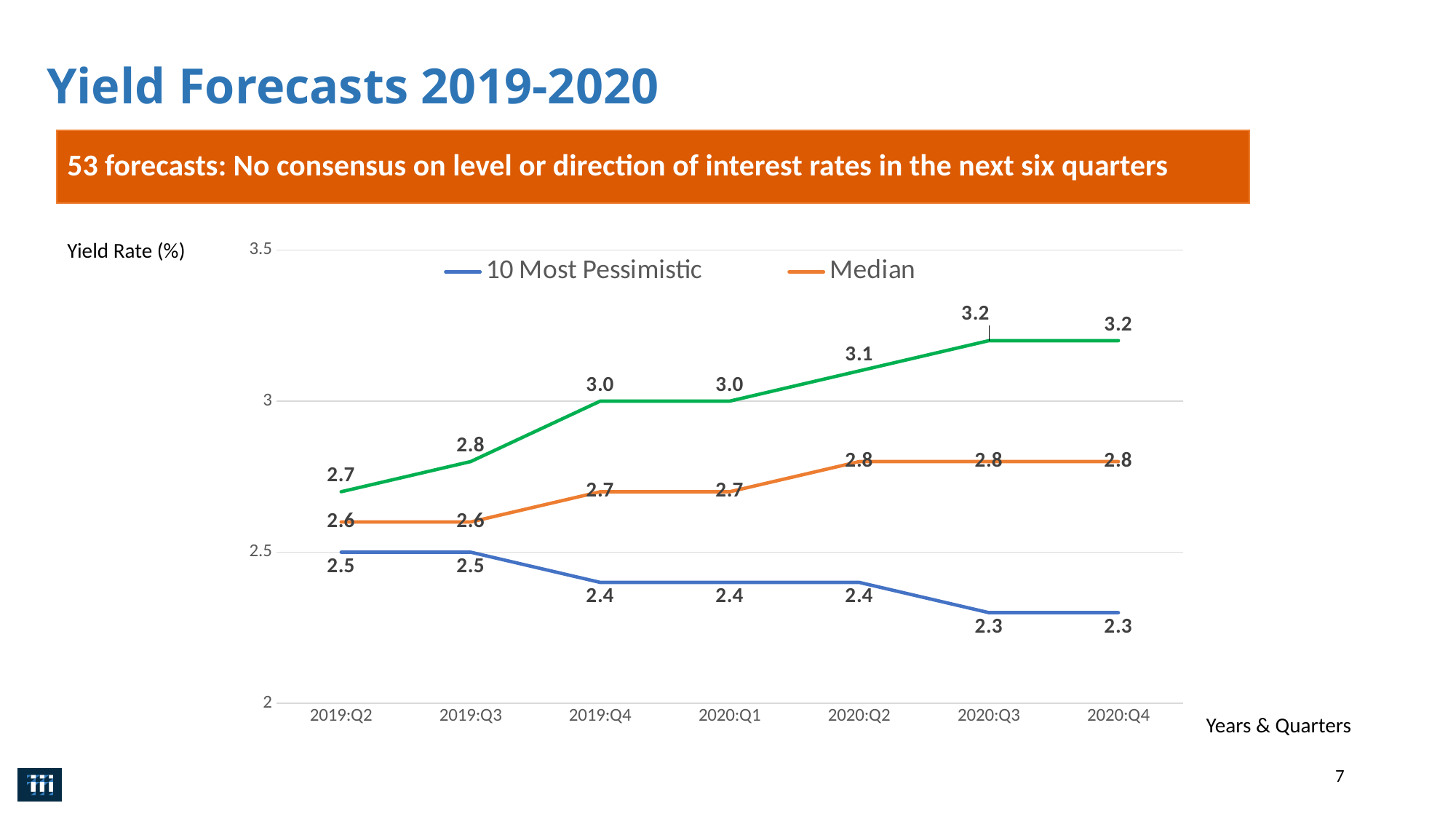
Which is larger at 2019:Q3, the Median forecast or the 10 Most Pessimistic forecast? Median What is the label of the y axis? Yield Rate (%) What is the Median yield rate forecast for 2020:Q2? 2.8 What kind of chart is shown on the slide? line chart What is the 10 Most Pessimistic yield rate forecast for 2019:Q4? 2.4 How many quarters are shown on the x axis? 7 How many series does the legend list? 2 Is the 10 Most Pessimistic value for 2020:Q1 greater or less than 2.5? less What is the difference between the Median and the 10 Most Pessimistic forecasts for 2020:Q4? 0.5 What is the Median yield rate forecast for 2019:Q2? 2.6 Does the 10 Most Pessimistic series rise or fall from 2019:Q2 to 2020:Q4? fall In which quarters does the 10 Most Pessimistic series reach its lowest value? 2020:Q3 and 2020:Q4